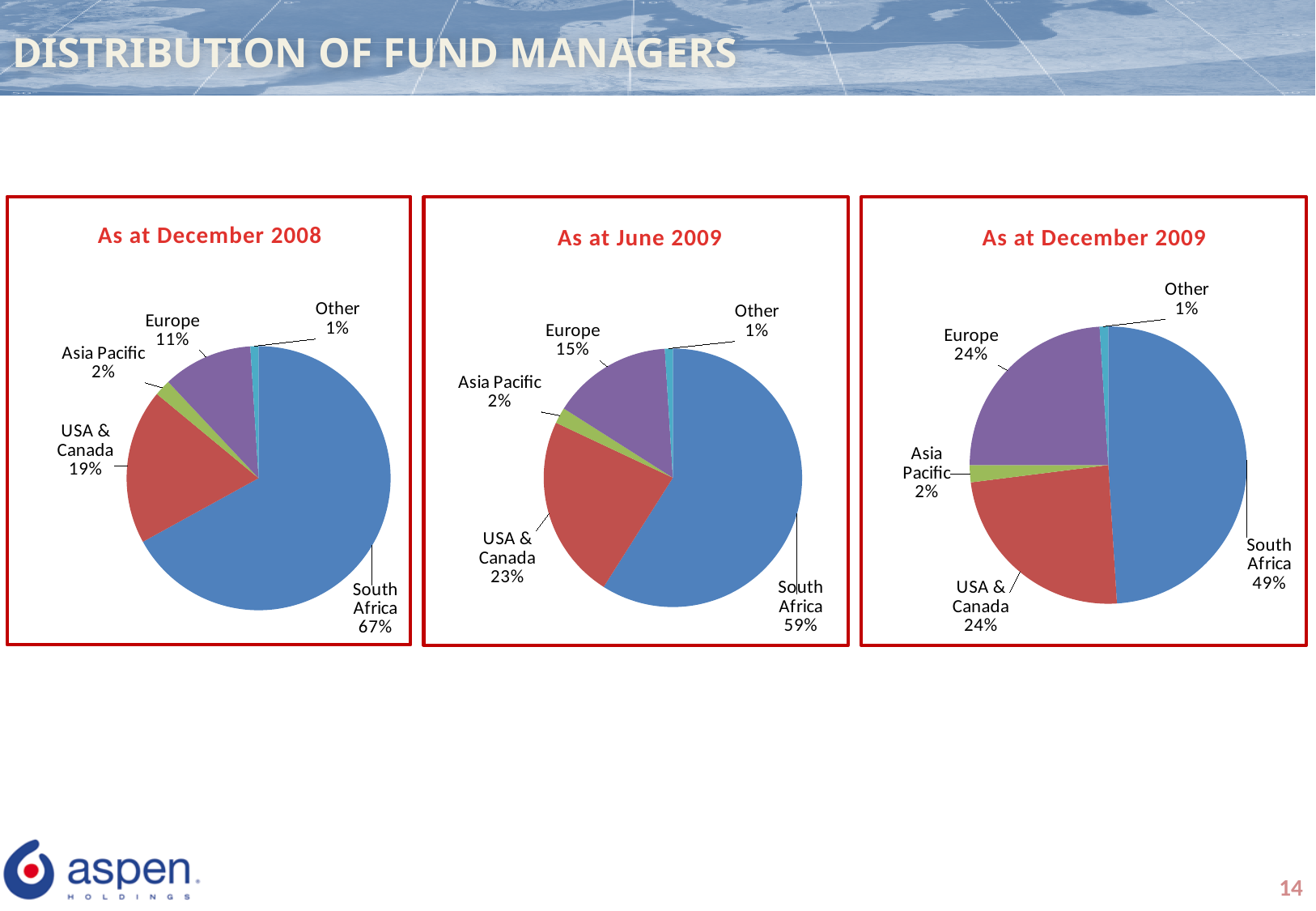
In the 'As at December 2009' chart, which category has the largest share? South Africa In the 'As at December 2008' chart, what is the difference between the South Africa share and the USA & Canada share? 48% In the 'As at December 2008' chart, what share does South Africa hold? 67% In the 'As at June 2009' chart, what share does Europe hold? 15% In the 'As at December 2009' chart, which is larger: the Europe share or the Asia Pacific share? Europe How many categories does the 'As at June 2009' pie chart show? 5 How many pie charts are shown on the slide? 3 In the 'As at December 2009' chart, what share does Europe hold? 24% In the 'As at June 2009' chart, which category has the smallest share? Other What kind of chart is used in the 'As at December 2008' panel? Pie chart In the 'As at June 2009' chart, what share does USA & Canada hold? 23% What is the title of the slide? DISTRIBUTION OF FUND MANAGERS